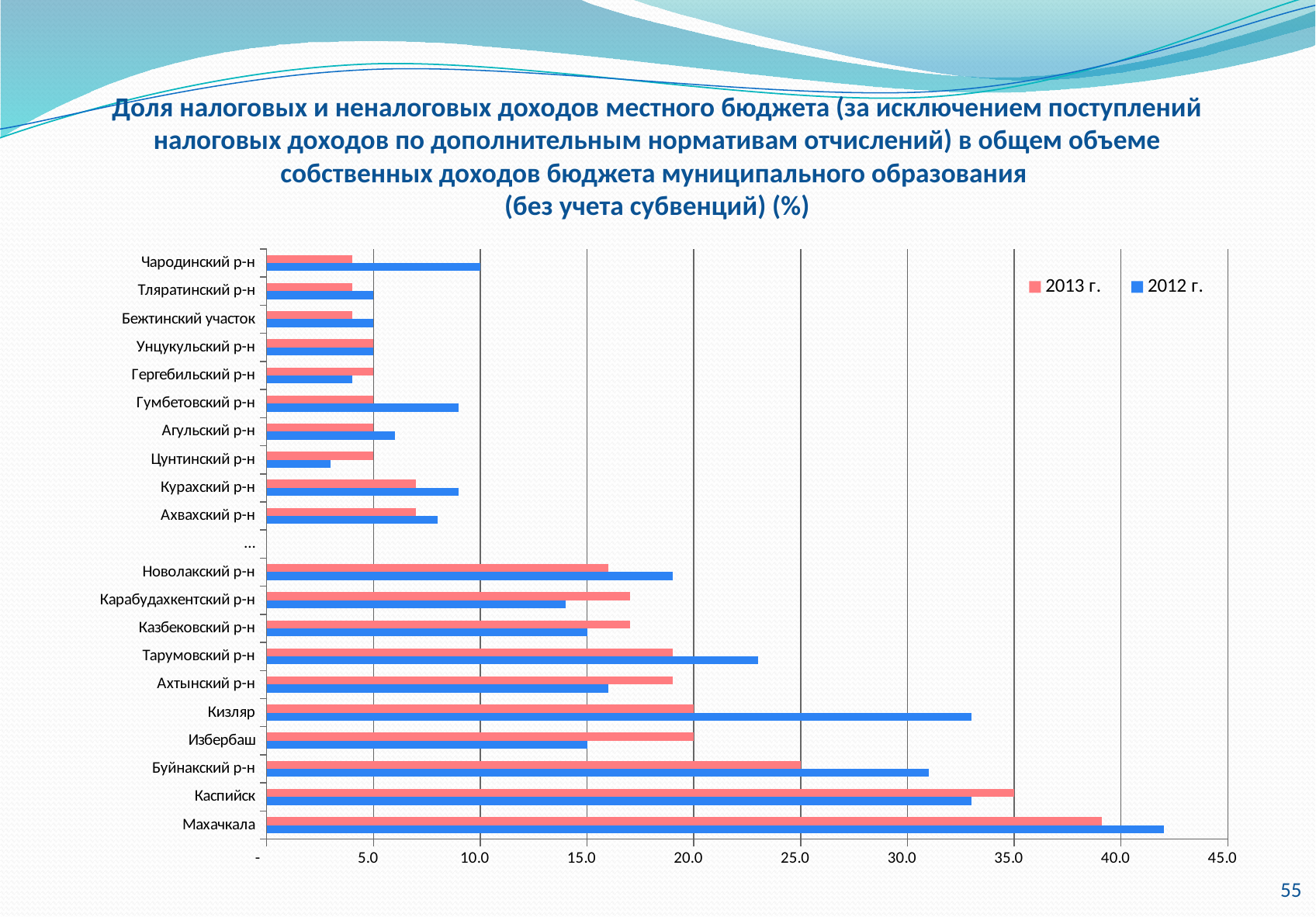
For Карабудахкентский р-н, which year has the larger value, 2012 г. or 2013 г.? 2013 г. Which municipality has the lowest value for 2012 г.? Цунтинский р-н Is the 2012 г. value for Кизляр greater or less than 30.0? greater For Кизляр, which year has the larger value, 2012 г. or 2013 г.? 2012 г. Is the 2012 г. value for Цунтинский р-н greater or less than 5.0? less Is the 2012 г. value for Махачкала greater or less than 40.0? greater Which municipality has the highest value for 2012 г.? Махачкала How many series does the legend list? 2 Which municipality has the highest value for 2013 г.? Махачкала What kind of chart is shown on the slide? bar chart Which series is shown in blue in the legend? 2012 г.